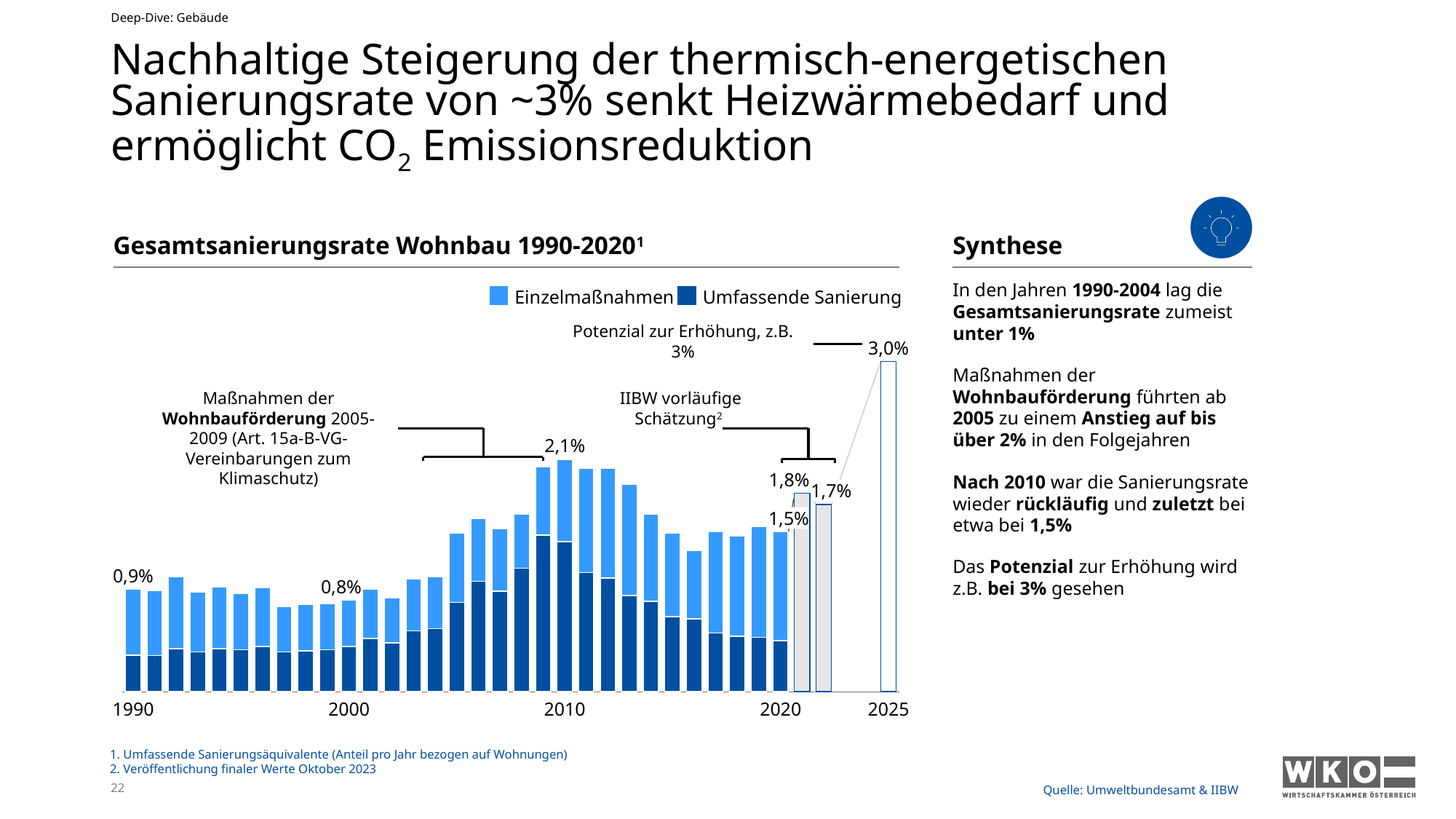
What is the total renovation rate shown for 2010? 2,1% Of the labelled years 1990, 2000, 2010 and 2020, which has the highest total renovation rate? 2010 What is the total renovation rate shown for 2020? 1,5% What is the total renovation rate (Gesamtsanierungsrate) shown for 1990? 0,9% What is the difference between the 2025 potential rate and the 2020 rate? 1,5 percentage points Does the total renovation rate rise or fall between 2010 and 2020? Fall What is the difference between the renovation rate in 2010 and in 2020? 0,6 percentage points What is the total renovation rate shown for 2000? 0,8% What potential renovation rate is shown for 2025? 3,0% Which year has the higher total renovation rate, 1990 or 2000? 1990 What kind of chart is used to show the Gesamtsanierungsrate? Stacked bar chart How many series does the legend list? 2